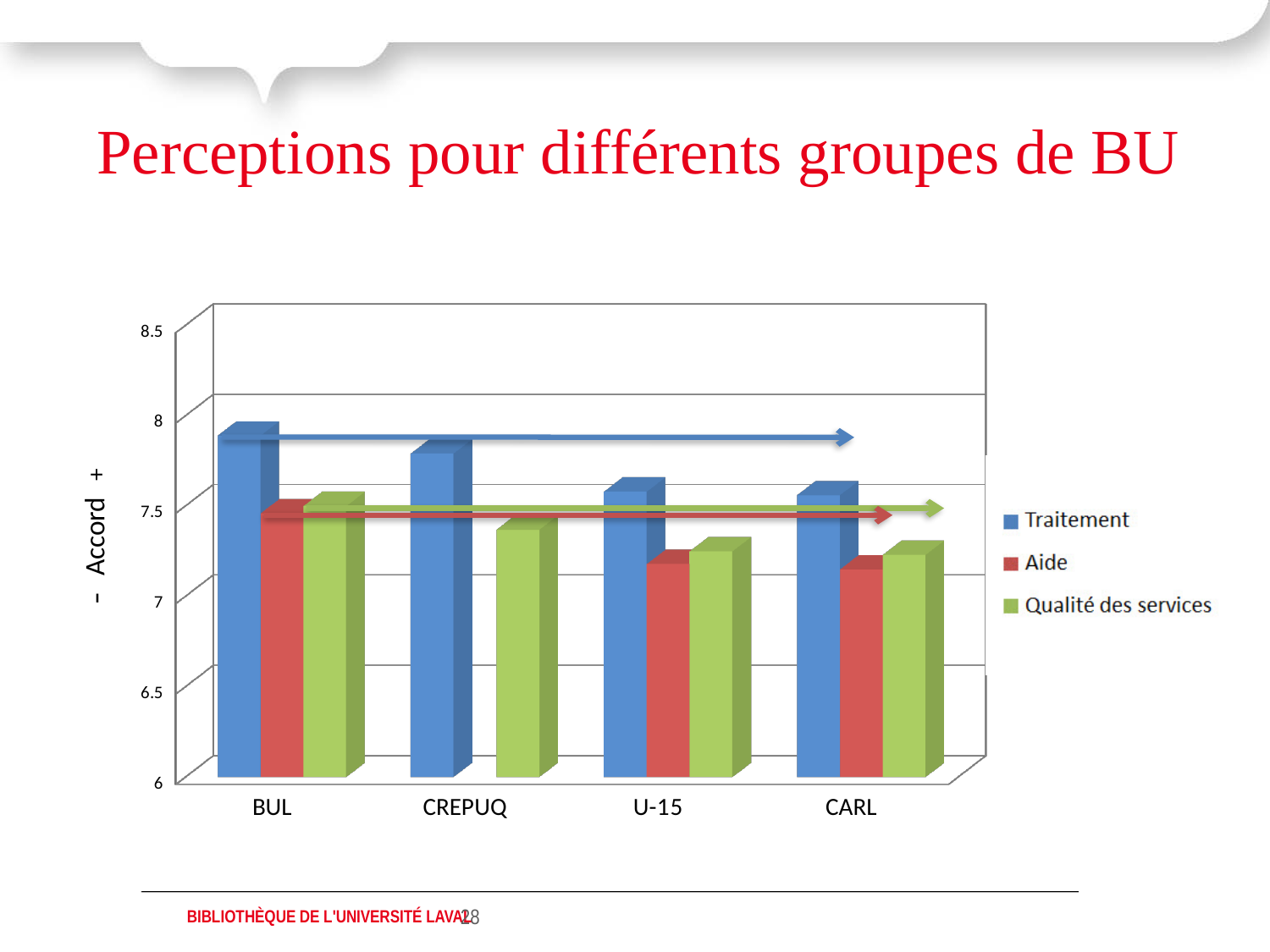
How many series does the chart legend list? 3 How many categories are shown on the x axis of the chart? 4 What kind of chart is shown on the slide? Bar chart Which category has no Aide bar in the chart? CREPUQ What is the title of the slide containing the chart? Perceptions pour différents groupes de BU Is the Traitement value for BUL greater or less than 7.5? greater Which category has the highest Qualité des services value? BUL Do the Traitement values rise or fall from BUL to CARL along the x axis? fall Which category has the highest Traitement value? BUL Is the Qualité des services value for CREPUQ greater or less than 7.5? less Which is larger, the Traitement value for BUL or the Traitement value for CREPUQ? BUL Is the Aide value for CARL greater or less than 7? greater